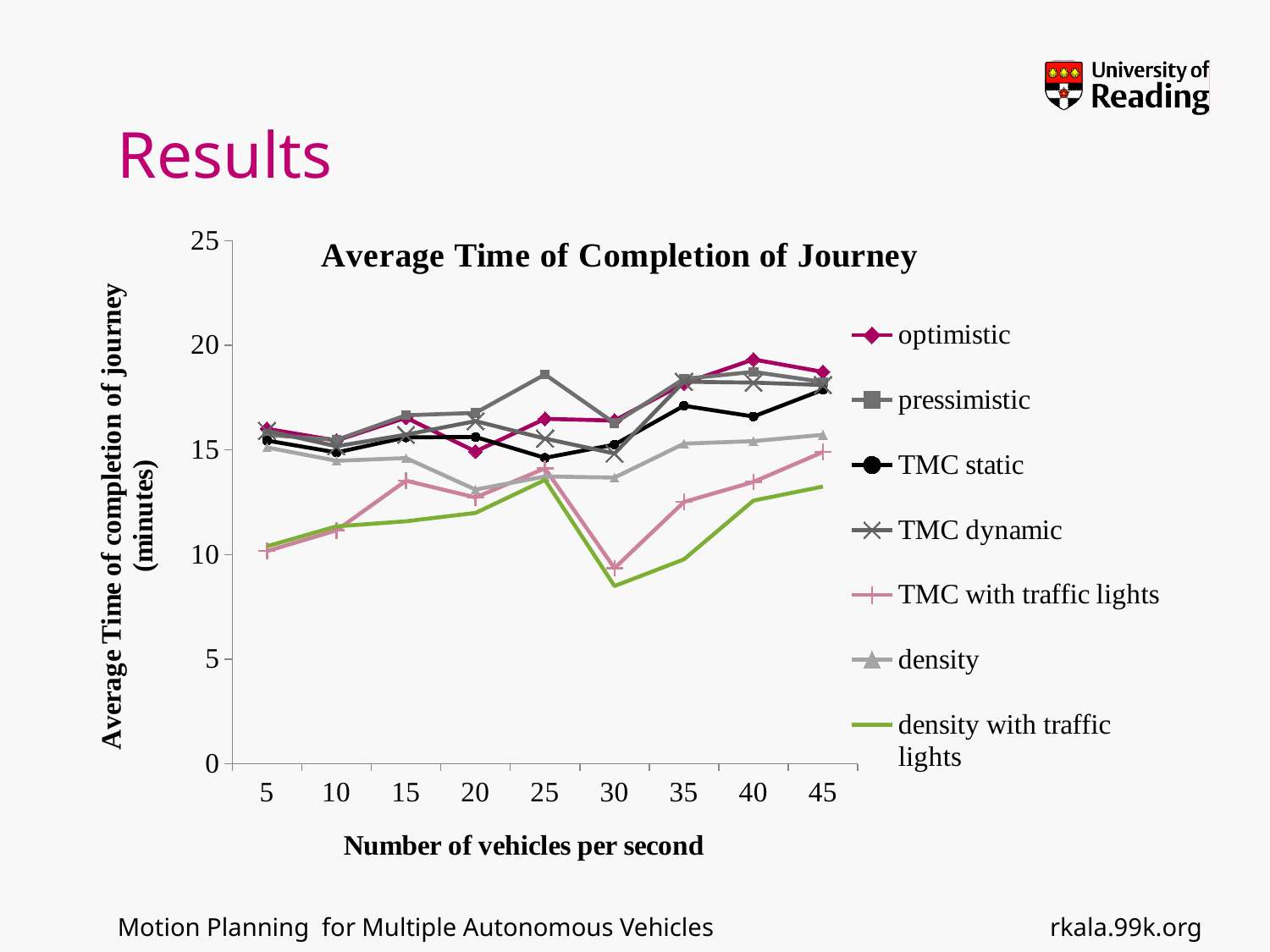
Which series has the lowest value at 30 vehicles per second? density with traffic lights Is the value for 'pressimistic' at 25 vehicles per second greater or less than 20? less How many series does the legend list? 7 Does the 'density with traffic lights' series rise or fall from 30 to 45 vehicles per second? rise What kind of chart is shown on the slide? line chart Is the value for 'TMC with traffic lights' at 5 vehicles per second greater or less than 15? less At 30 vehicles per second, which is larger: the value for 'optimistic' or for 'density with traffic lights'? optimistic What is the title of the chart? Average Time of Completion of Journey How many points are on the x axis (number of vehicles per second)? 9 Is the value for 'density with traffic lights' at 30 vehicles per second greater or less than 10? less What is the label of the x axis? Number of vehicles per second